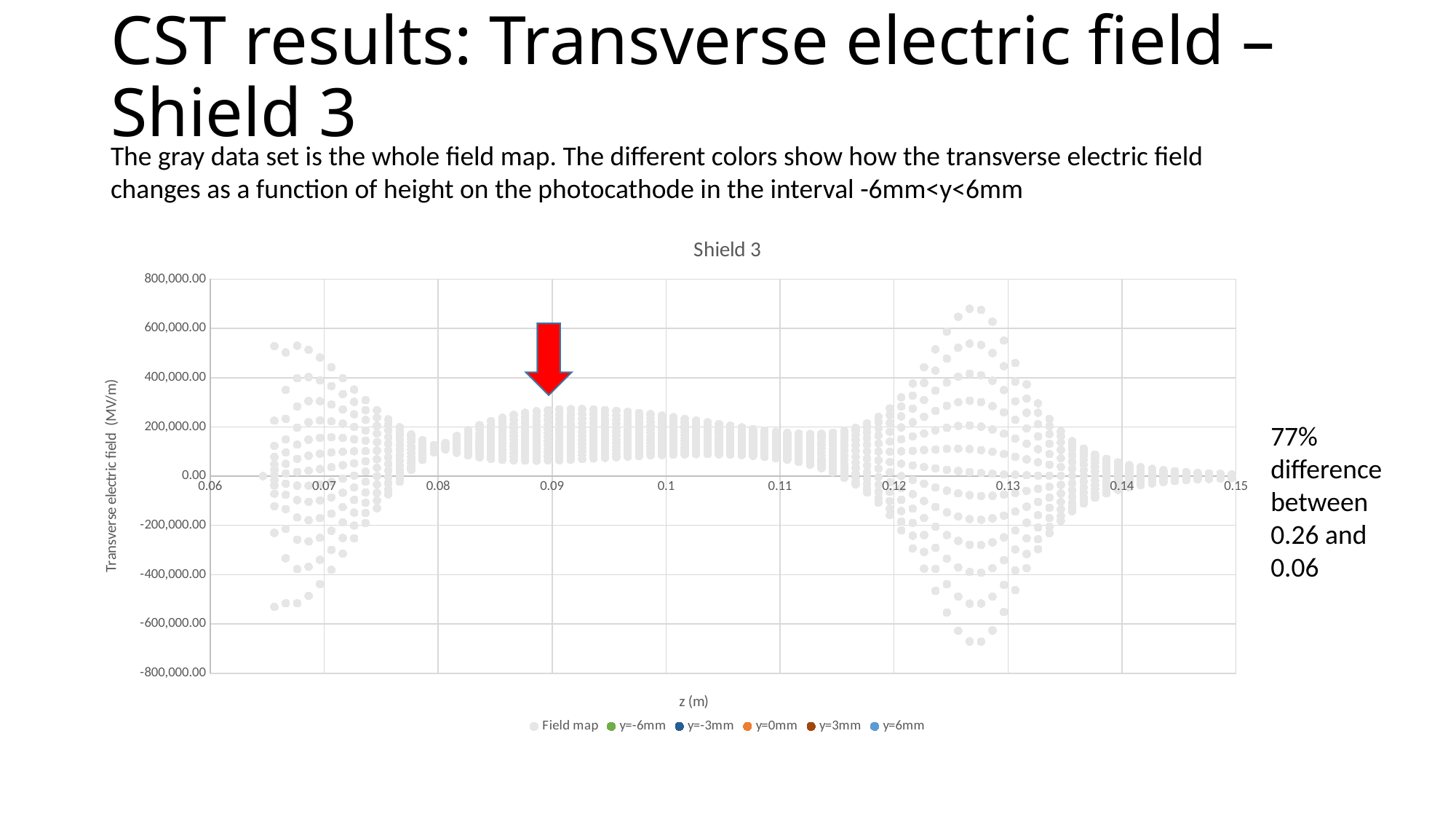
What kind of chart is shown on the slide? scatter chart Are the plotted values near z = 0.15 greater or less than 200,000.00? less What is the minimum value shown on the x axis? 0.06 Is the highest plotted value near z = 0.09 greater or less than 400,000.00? less What is the title of the chart? Shield 3 Which series in the legend is plotted in gray? Field map Is the highest plotted value near z = 0.13 greater or less than 600,000.00? greater What is the label of the x axis? z (m) What is the maximum value shown on the y axis? 800,000.00 How many series does the chart legend list? 6